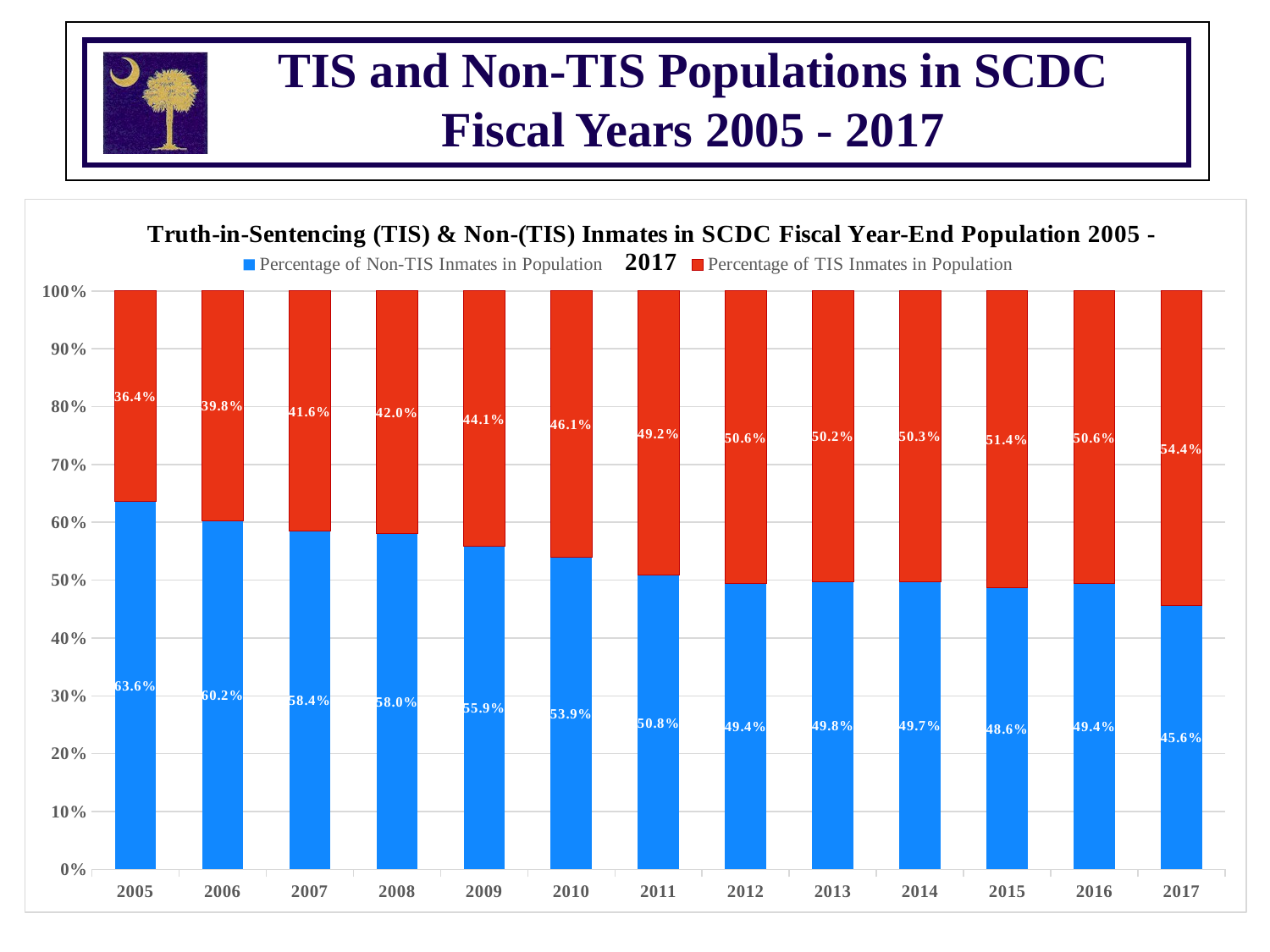
How many fiscal years are shown on the x axis? 13 In which year is the percentage of Non-TIS inmates lowest? 2017 In which year is the percentage of TIS inmates highest? 2017 What percentage of Non-TIS inmates is shown for 2017? 45.6% What percentage of TIS inmates is shown for 2011? 49.2% What is the difference between the Non-TIS percentage in 2005 and the Non-TIS percentage in 2017? 18.0% How many series does the legend list? 2 Which is larger in 2010: the percentage of TIS inmates or the percentage of Non-TIS inmates? Non-TIS inmates What percentage of TIS inmates is shown for 2005? 36.4% What kind of chart is shown on the slide? Stacked bar chart Which colour represents the percentage of Non-TIS inmates in the population? Blue Does the percentage of TIS inmates generally rise or fall from 2005 to 2017? Rise